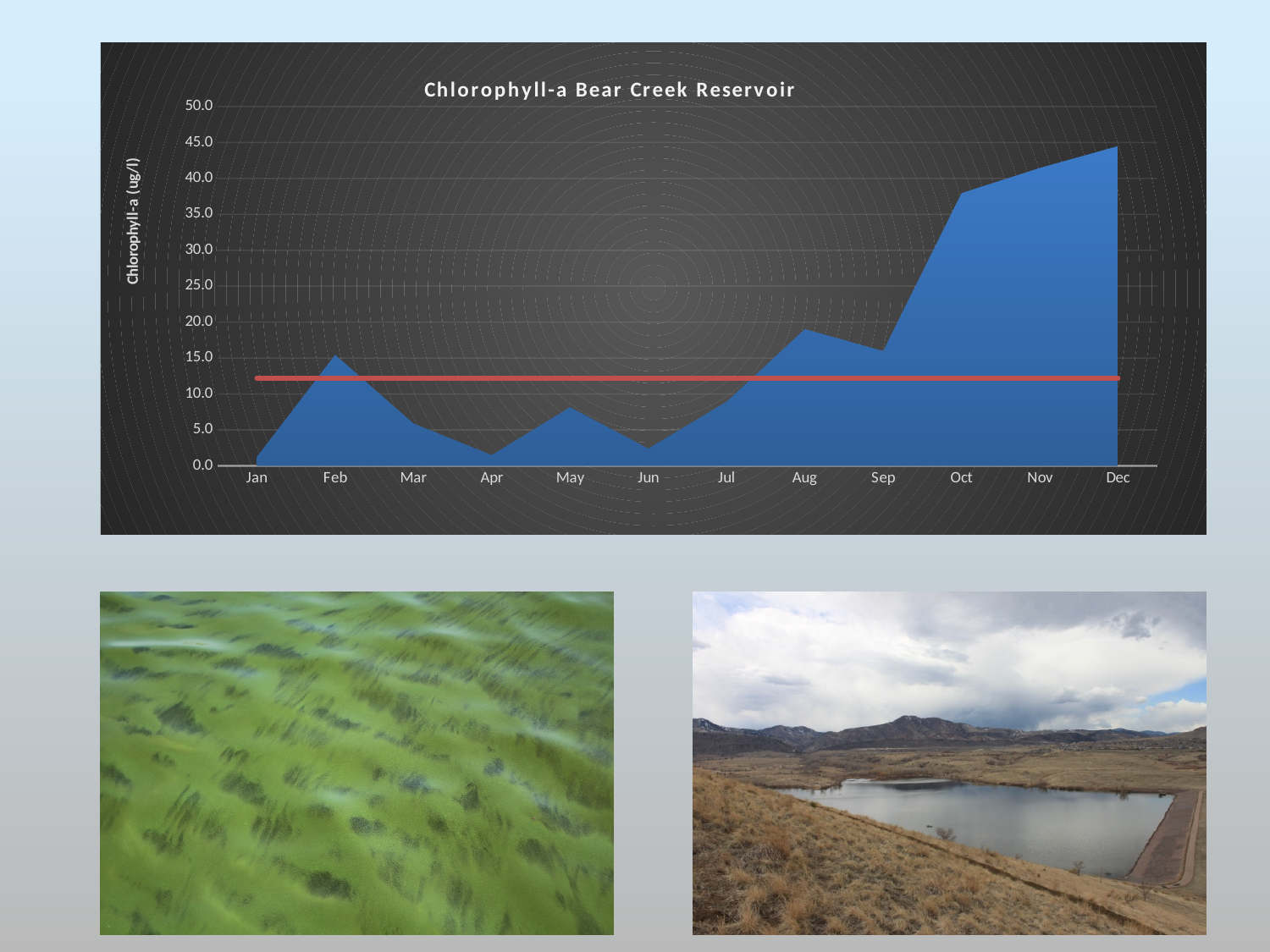
Is the value for Aug greater or less than 15.0? greater Which month has the larger chlorophyll-a value, Feb or Mar? Feb What kind of chart is shown on the slide? Combination area and line chart Overall, do the chlorophyll-a values rise or fall from Jan to Dec? rise Is the value for Oct greater or less than 35.0? greater What is the label on the vertical axis of the chart? Chlorophyll-a (ug/l) What is the title of the chart? Chlorophyll-a Bear Creek Reservoir How many months are plotted along the x axis of the chart? 12 Is the value for Apr greater or less than 5.0? less Which month has the highest chlorophyll-a value? Dec